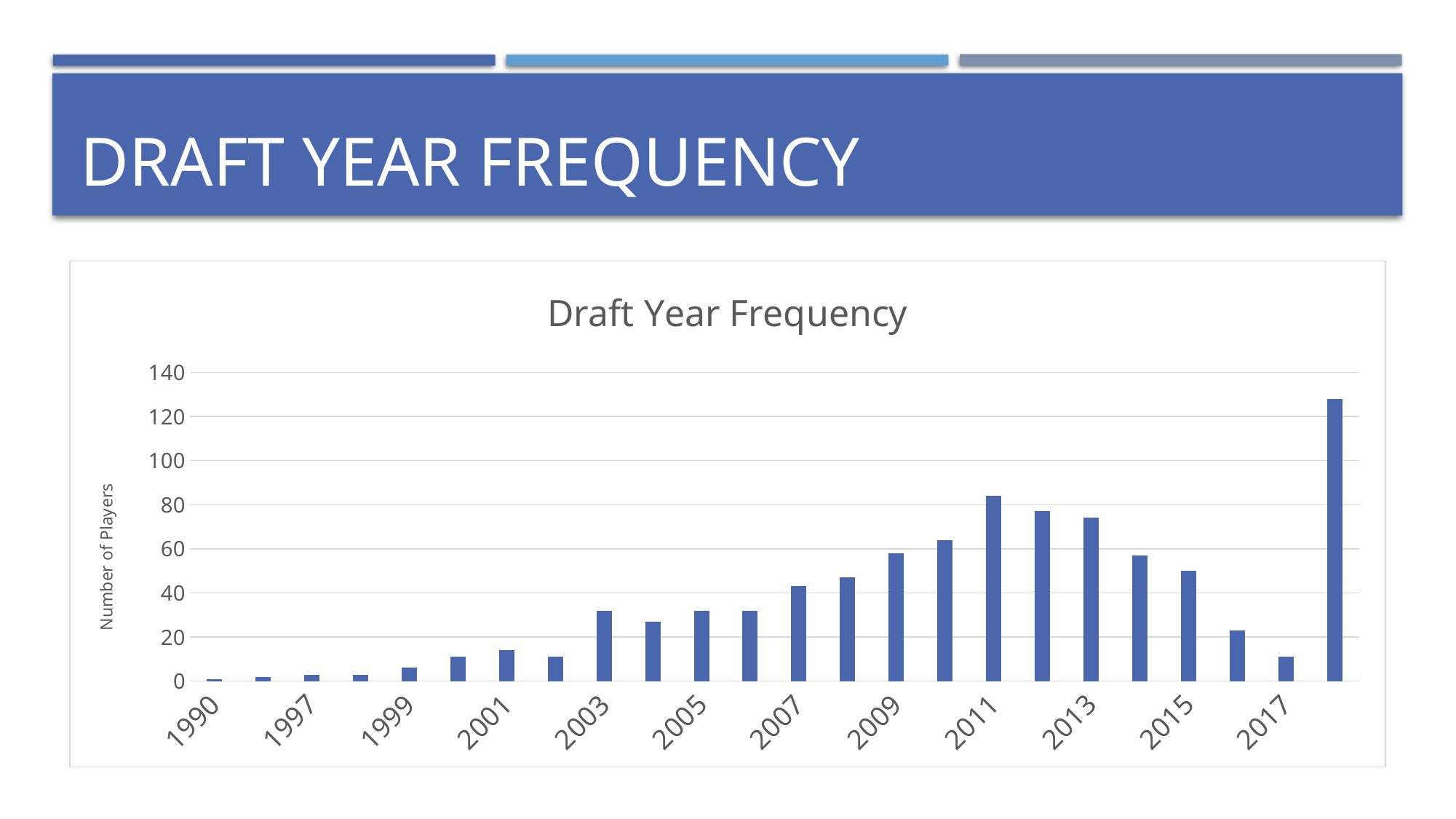
What is the label on the vertical axis of the chart? Number of Players What is the title of the chart? Draft Year Frequency Do the values rise or fall from 2003 to 2011? rise Is the value for 2013 greater or less than 80? less Is the value for 2011 greater or less than 80? greater Is the value for 2003 greater or less than 40? less How many bars are plotted in the chart? 24 Which year has the larger value, 2011 or 2013? 2011 What kind of chart is shown on the slide? bar chart Which year has the larger value, 2003 or 2007? 2007